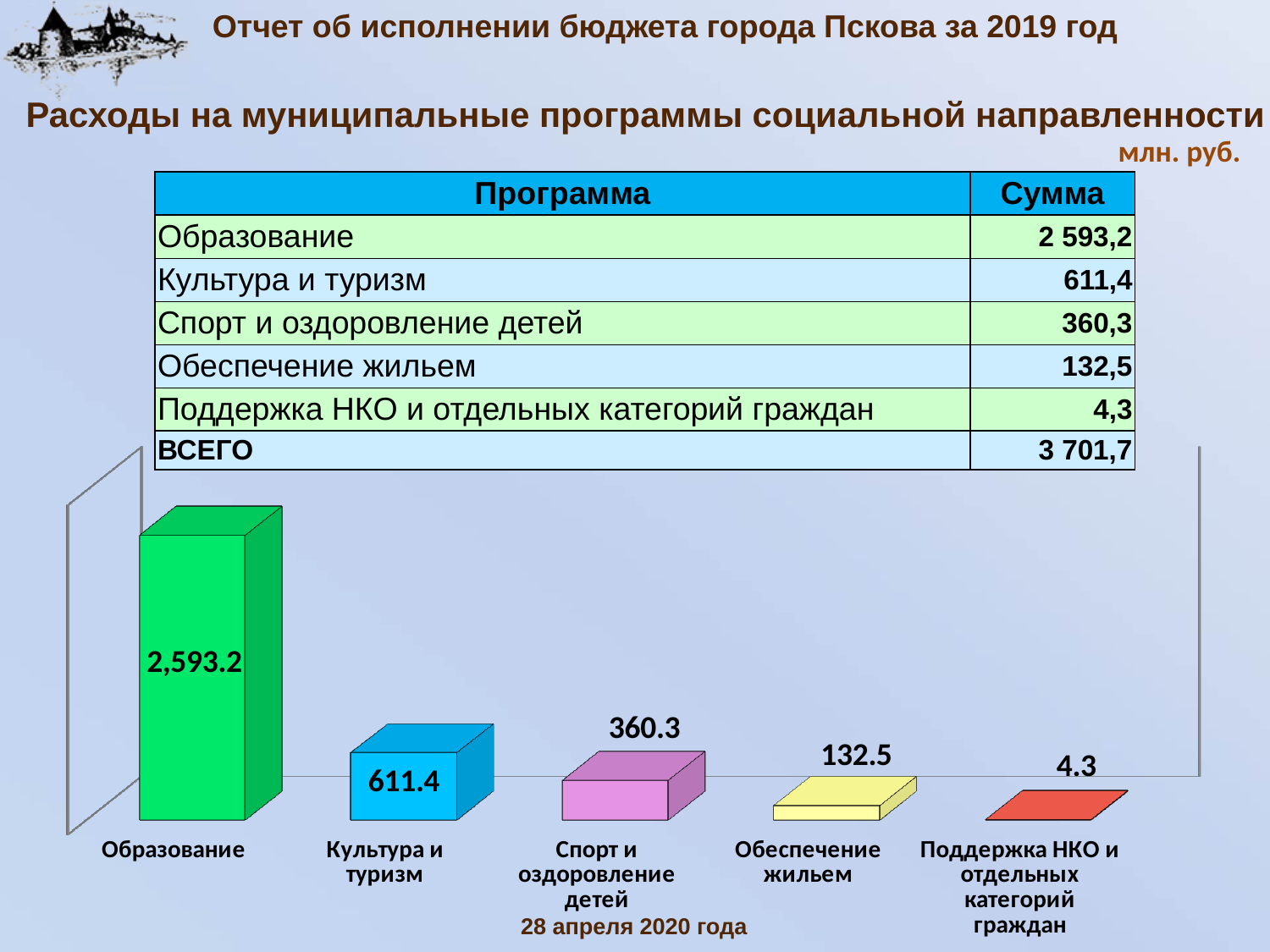
What is the value shown for Культура и туризм in the bar chart? 611.4 What is the difference between the values for Спорт и оздоровление детей and Обеспечение жильем in the bar chart? 227.8 Which category has the highest value in the bar chart? Образование How many categories are shown in the bar chart? 5 What is the value shown for Поддержка НКО и отдельных категорий граждан in the bar chart? 4.3 What kind of chart is shown on the slide? Bar chart What is the value shown for Обеспечение жильем in the bar chart? 132.5 What is the value shown for Образование in the bar chart? 2,593.2 Which category has the lowest value in the bar chart? Поддержка НКО и отдельных категорий граждан What is the difference between the values for Образование and Культура и туризм in the bar chart? 1,981.8 What is the value shown for Спорт и оздоровление детей in the bar chart? 360.3 Which is larger in the bar chart: Культура и туризм or Спорт и оздоровление детей? Культура и туризм